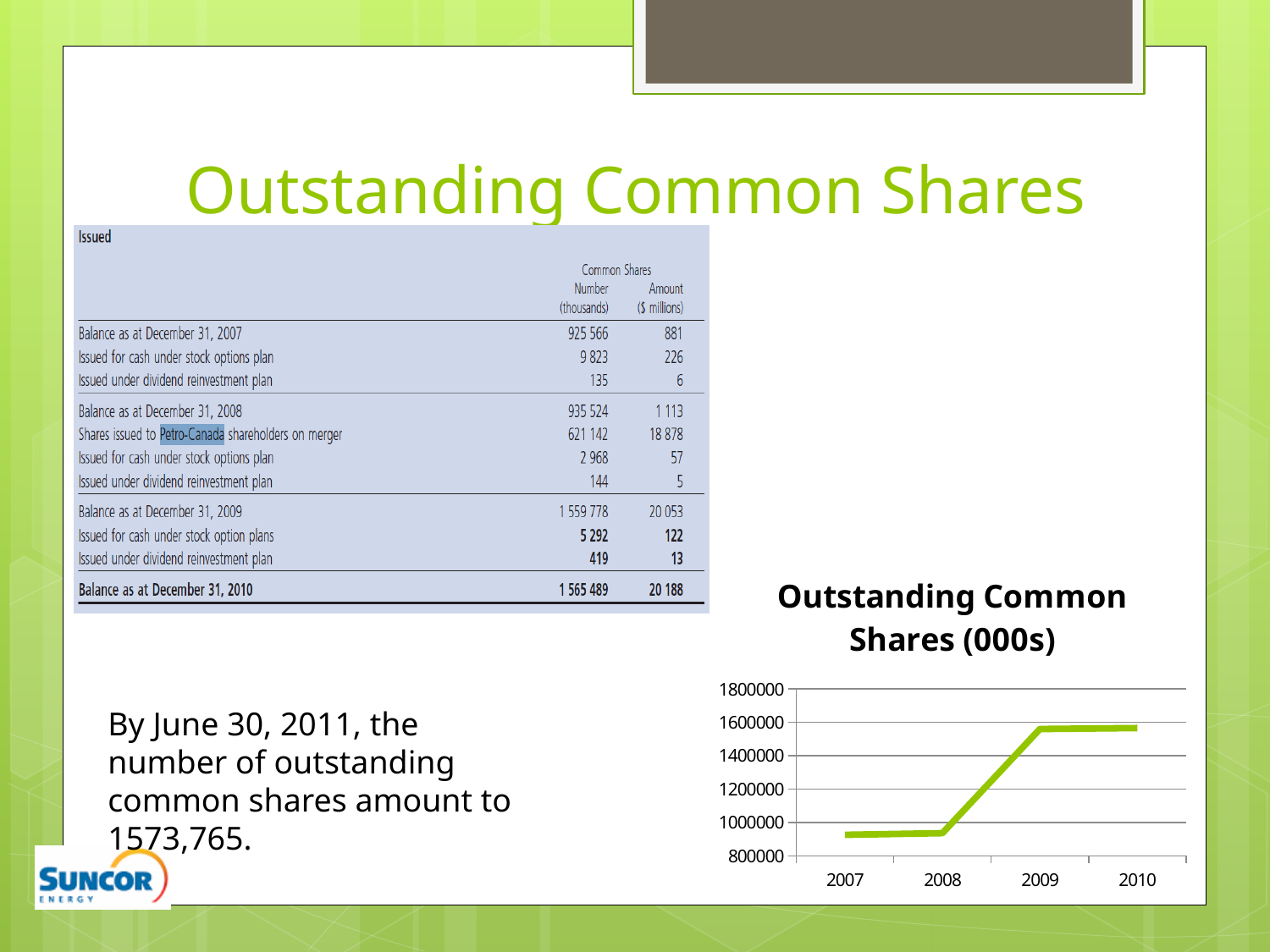
Which is larger, the value for 2007 or the value for 2009? 2009 Is the value for 2009 greater or less than 1400000? greater Is the value for 2007 greater or less than 1000000? less What is the title of the chart? Outstanding Common Shares (000s) Is the value for 2010 greater or less than 1600000? less What kind of chart is shown on the slide? line chart Do the values rise or fall from 2007 to 2010? rise How many years are plotted on the x axis of the chart? 4 Between which two consecutive years does the line show the largest increase? 2008 to 2009